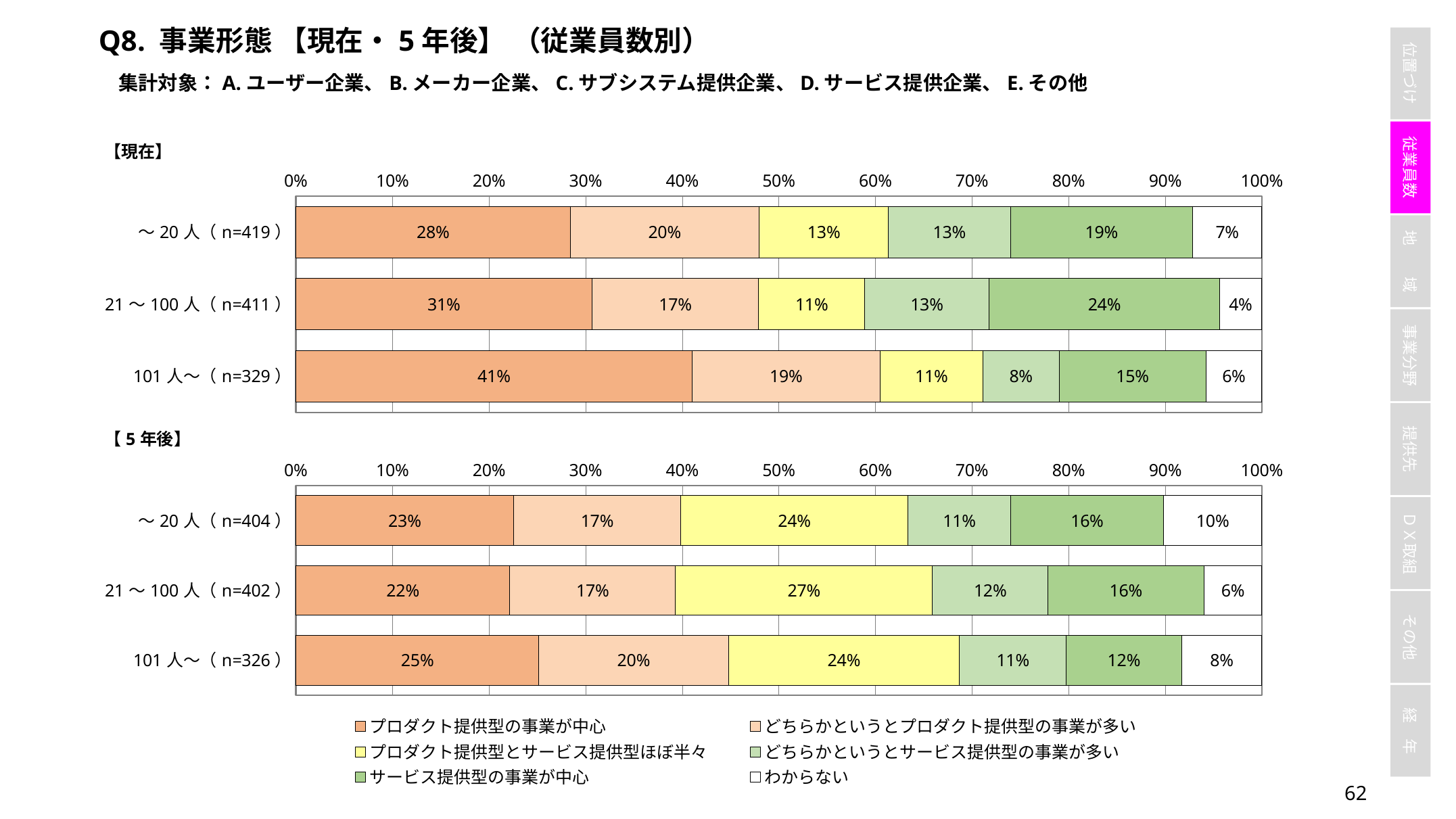
In the 【現在】 chart, what is the value for プロダクト提供型の事業が中心 for 101人～ (n=329)? 41% How many employee-size groups are shown in the 【5年後】 chart? 3 In the 【現在】 chart, which employee-size group has the lowest value for サービス提供型の事業が中心? 101人～ (n=329) In the 【5年後】 chart, what is the combined value of プロダクト提供型の事業が中心 and どちらかというとプロダクト提供型の事業が多い for 101人～ (n=326)? 45% In the 【現在】 chart, which employee-size group has the highest value for プロダクト提供型の事業が中心? 101人～ (n=329) How many series does the legend list? 6 In the 【5年後】 chart, what is the value for プロダクト提供型とサービス提供型ほぼ半々 for 21～100人 (n=402)? 27% In the 【現在】 chart, what is the difference between the プロダクト提供型の事業が中心 values for 101人～ (n=329) and ～20人 (n=419)? 13 percentage points In the 【5年後】 chart, which is larger for ～20人 (n=404): プロダクト提供型の事業が中心 or プロダクト提供型とサービス提供型ほぼ半々? プロダクト提供型とサービス提供型ほぼ半々 What kind of chart is the 【現在】 chart? Stacked bar chart In the 【5年後】 chart, what is the value for サービス提供型の事業が中心 for 101人～ (n=326)? 12% In the 【現在】 chart, what is the value for わからない for ～20人 (n=419)? 7%